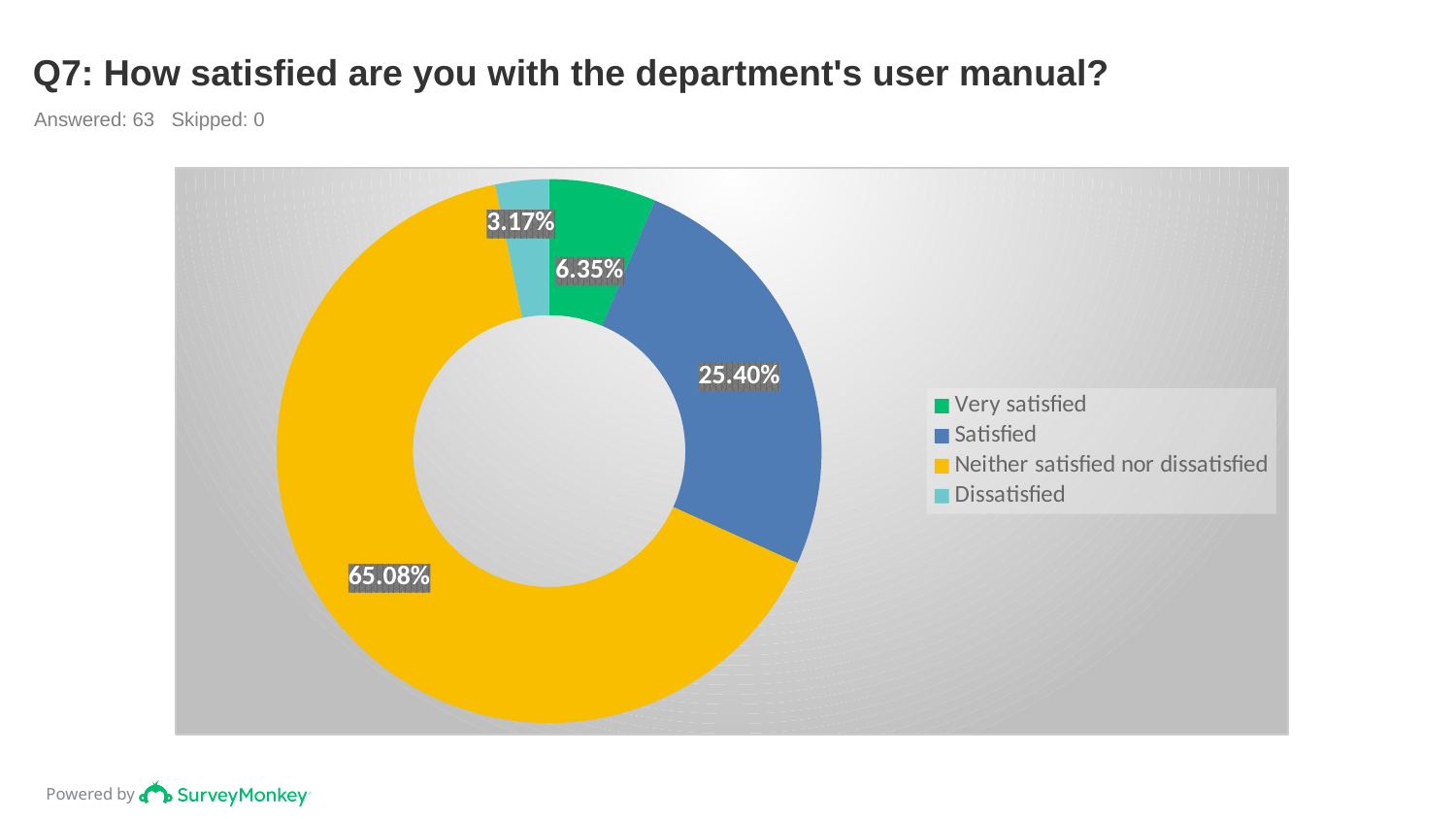
How many response categories are shown in the chart? 4 What percentage of respondents answered "Satisfied"? 25.40% What percentage of respondents answered "Dissatisfied"? 3.17% What colour represents "Satisfied" in the chart? Blue What kind of chart is shown on the slide? Pie chart (donut) What percentage of respondents answered "Neither satisfied nor dissatisfied"? 65.08% How many respondents answered this question? 63 Which response category has the largest share? Neither satisfied nor dissatisfied Which response category has the smallest share? Dissatisfied What percentage of respondents answered "Very satisfied"? 6.35% Which is larger, the share for "Very satisfied" or the share for "Dissatisfied"? Very satisfied What is the difference in percentage points between "Neither satisfied nor dissatisfied" and "Satisfied"? 39.68